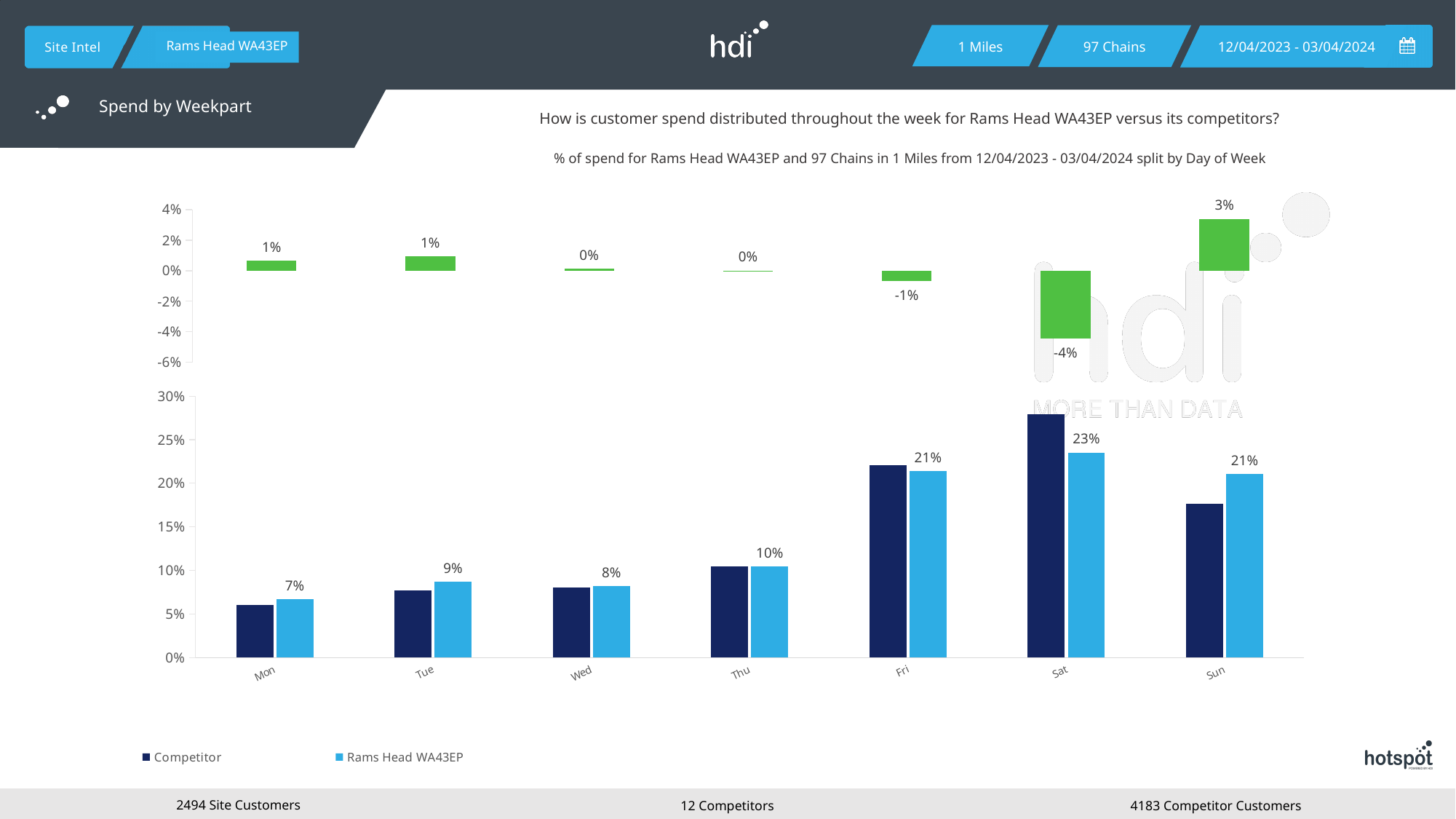
In the bottom bar chart, what is the value for Rams Head WA43EP on Sat? 23% In the bottom bar chart, on which day is the Rams Head WA43EP value highest? Sat How many days of the week are shown on the x axis of the bottom bar chart? 7 In the top chart, what is the value shown for Sat? -4% In the bottom bar chart, on which day is the Rams Head WA43EP value lowest? Mon In the bottom bar chart, which is larger on Sat: the Competitor bar or the Rams Head WA43EP bar? Competitor In the bottom bar chart, what is the difference between the Rams Head WA43EP values for Sat and Thu? 13% In the bottom bar chart, is the Competitor value for Sat greater or less than 25%? greater In the bottom bar chart, what is the value for Rams Head WA43EP on Mon? 7% In the bottom bar chart, which is larger on Sun: the Competitor bar or the Rams Head WA43EP bar? Rams Head WA43EP In the top chart, which day has the highest value? Sun How many series does the legend of the bottom bar chart list? 2